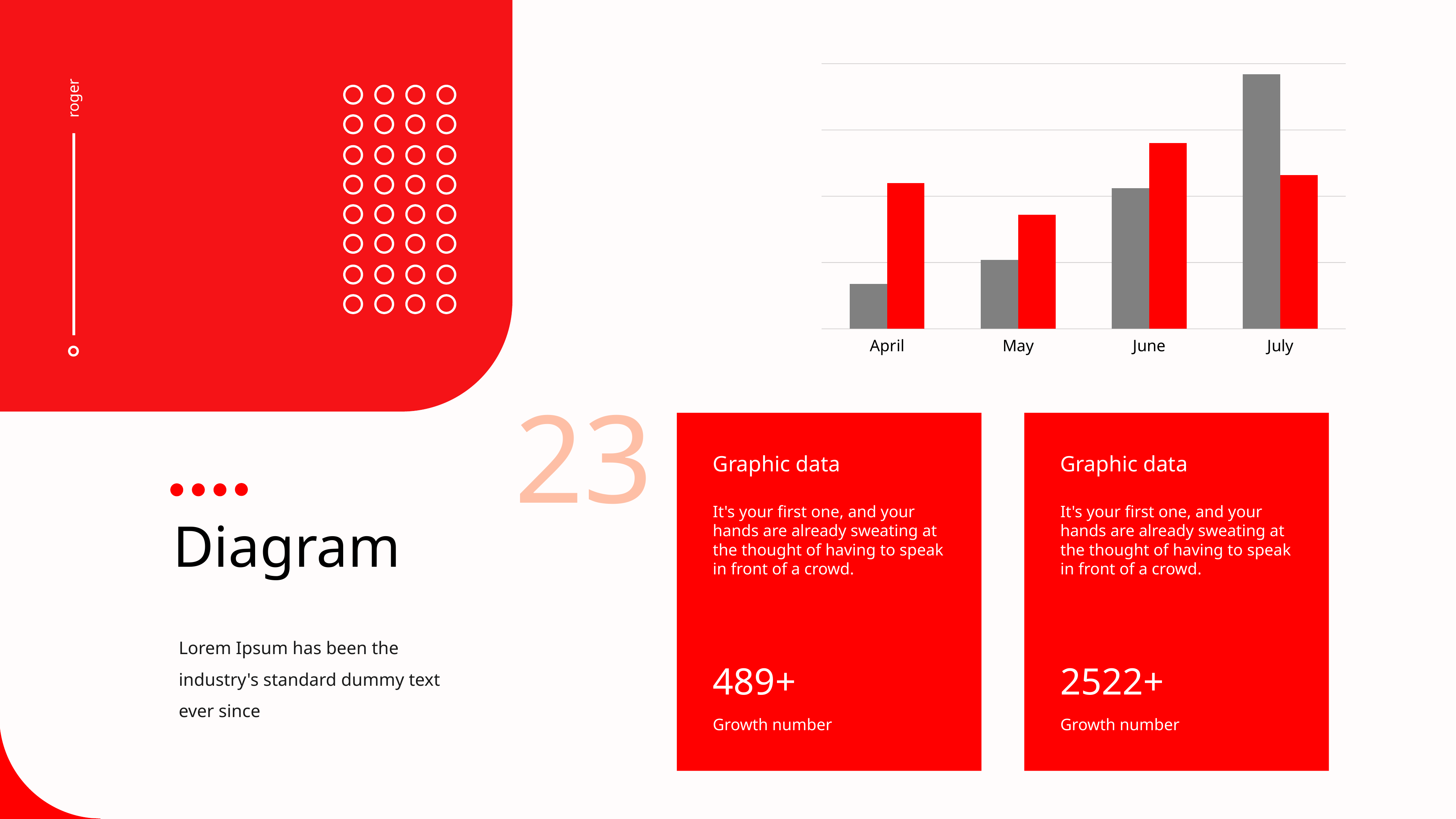
Do the gray bars rise or fall from April to July? Rise Which month has the tallest gray bar? July How many categories are shown on the x axis of the chart? 4 What two colours are used for the bars in the chart? Gray and red Which month has the tallest red bar? June What kind of chart is shown on the slide? Bar chart In April, which bar is taller, the gray bar or the red bar? The red bar Which month has the shortest gray bar? April Which month has the shortest red bar? May How many bars are shown for each month in the chart? 2 In July, which bar is taller, the gray bar or the red bar? The gray bar Which is taller, the red bar for June or the red bar for April? The red bar for June